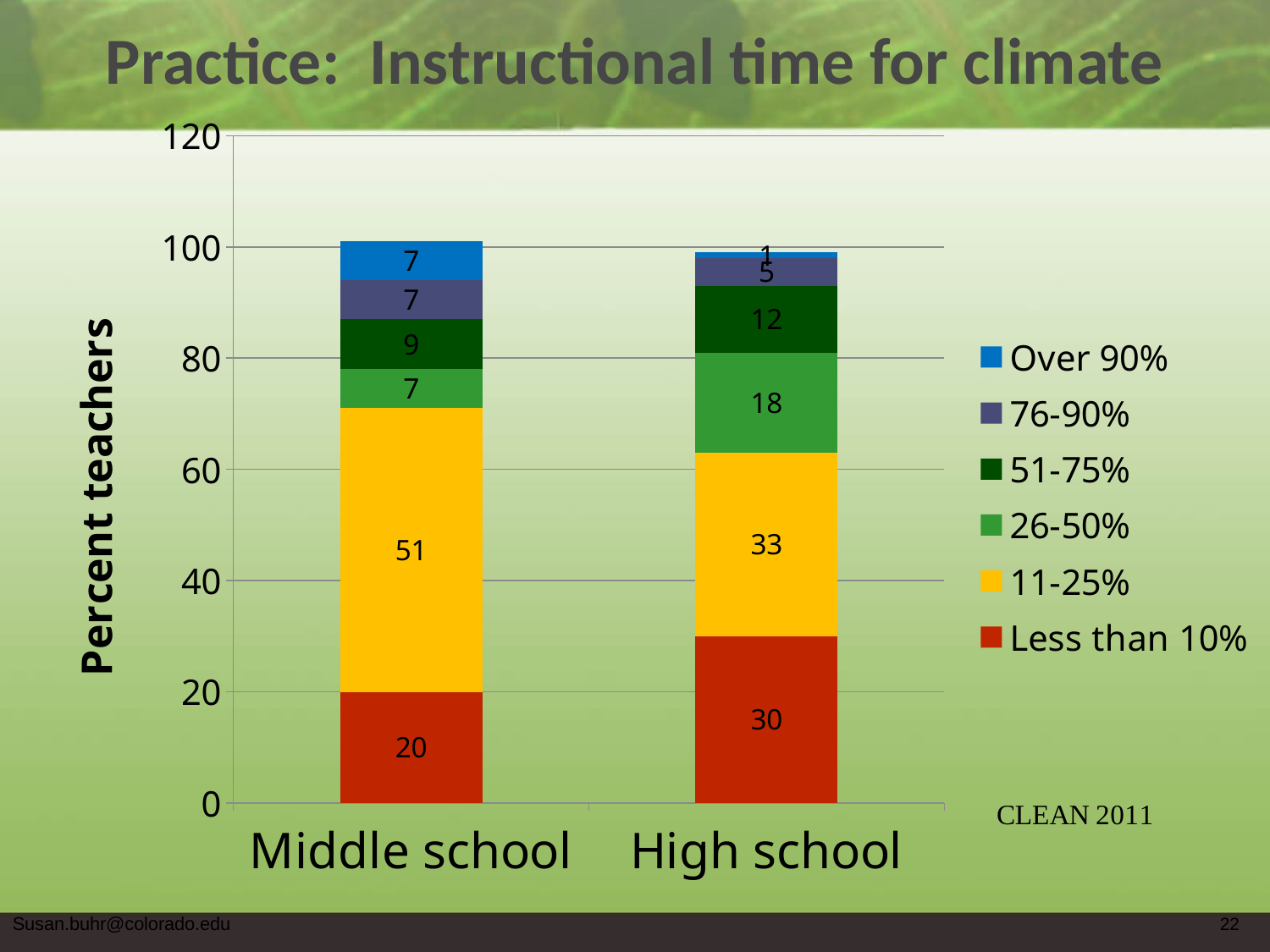
What is the value for the 51-75% series for Middle school? 9 What is the total of the stacked bar for High school? 99 What is the difference between the 11-25% values for Middle school and High school? 18 Which is larger, the Less than 10% value for Middle school or for High school? High school What kind of chart is shown on the slide? Stacked bar chart Which series has the lowest value for High school? Over 90% What is the value for the Less than 10% series for High school? 30 What is the value for the 26-50% series for High school? 18 How many series does the legend list? 6 Which series has the highest value for Middle school? 11-25% What is the value for the 11-25% series for Middle school? 51 How many categories are shown on the x axis? 2